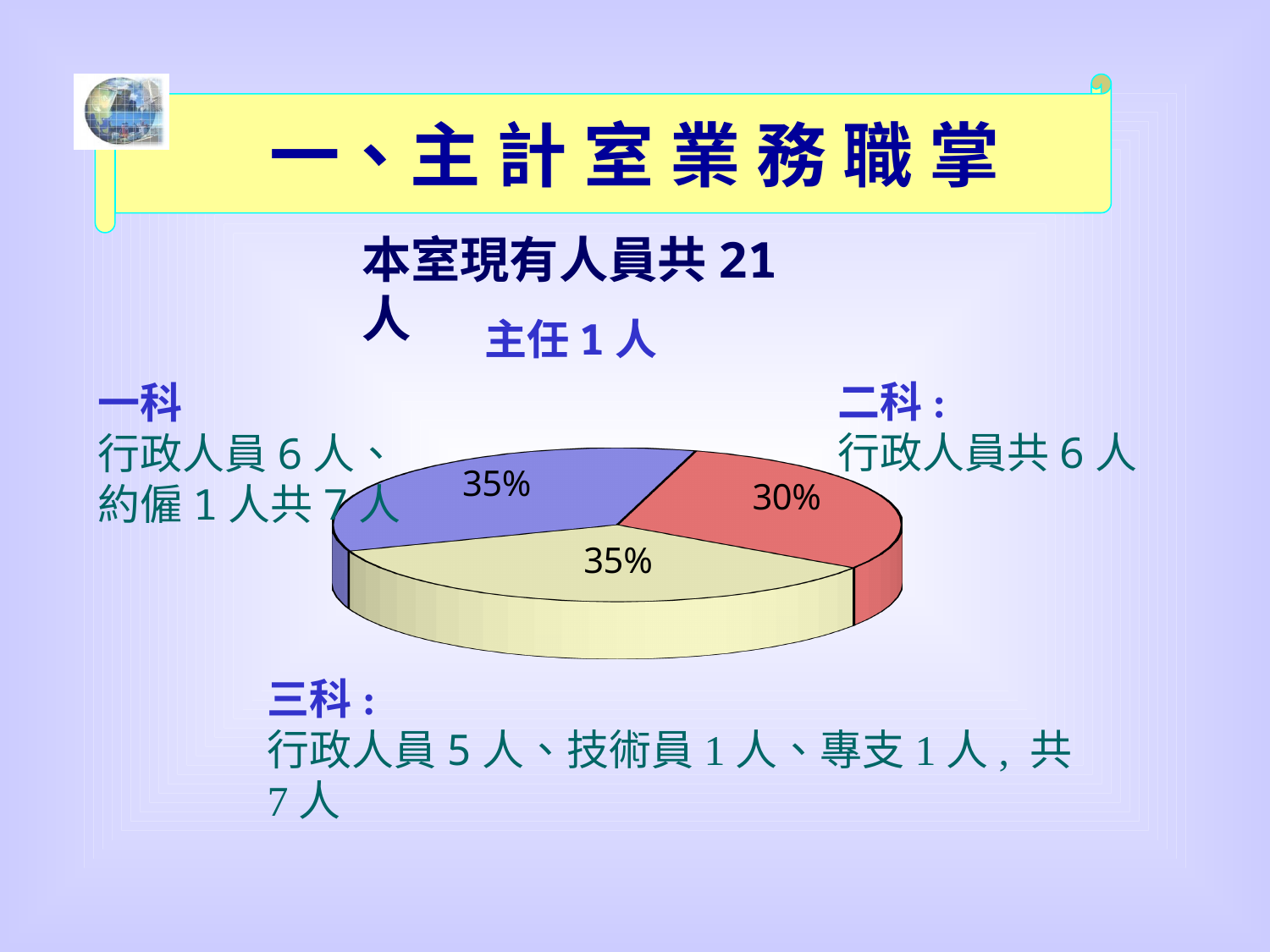
How many slices of the pie chart are labelled 35%? 2 Is the value of the red slice greater or less than 35%? less According to the text above the pie chart, how many staff does the office have in total? 21 人 How many slices does the pie chart have? 3 What percentage is shown on the red slice of the pie chart? 30% What is the title of the slide containing the pie chart? 一、主計室業務職掌 What is the difference between the blue slice's percentage and the red slice's percentage? 5% What percentage is shown on the yellow slice of the pie chart? 35% What percentage is shown on the blue slice of the pie chart? 35% Which is larger, the blue slice or the red slice? the blue slice What kind of chart is shown on the slide? pie chart Which slice of the pie chart is the smallest? the red slice (30%)